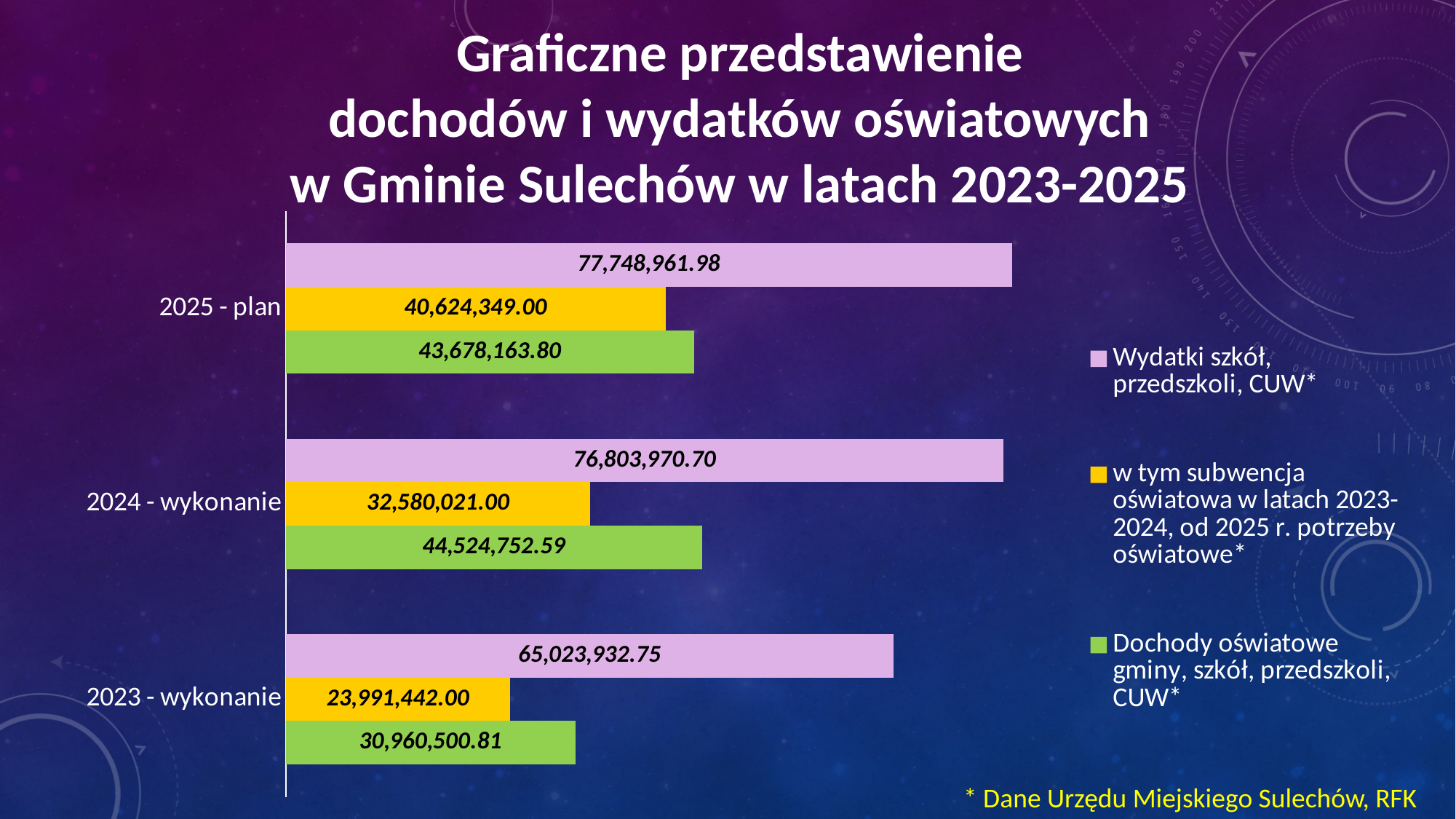
What is the value of Dochody oświatowe gminy, szkół, przedszkoli, CUW for 2023 - wykonanie? 30,960,500.81 By how much does the subwencja oświatowa value for 2025 - plan exceed the value for 2023 - wykonanie? 16,632,907.00 What is the value of Wydatki szkół, przedszkoli, CUW for 2025 - plan? 77,748,961.98 What kind of chart is shown on the slide? Bar chart For 2024 - wykonanie, which is larger: Dochody oświatowe or the subwencja oświatowa value? Dochody oświatowe How many categories (years) are shown on the chart? 3 What is the value of the subwencja oświatowa series for 2024 - wykonanie? 32,580,021.00 How many series does the legend list? 3 Does the subwencja oświatowa value rise or fall from 2023 - wykonanie to 2025 - plan? Rise Which category has the lowest value for Dochody oświatowe gminy, szkół, przedszkoli, CUW? 2023 - wykonanie Which category has the highest value for Wydatki szkół, przedszkoli, CUW? 2025 - plan What is the difference between Wydatki szkół, przedszkoli, CUW for 2025 - plan and for 2024 - wykonanie? 944,991.28